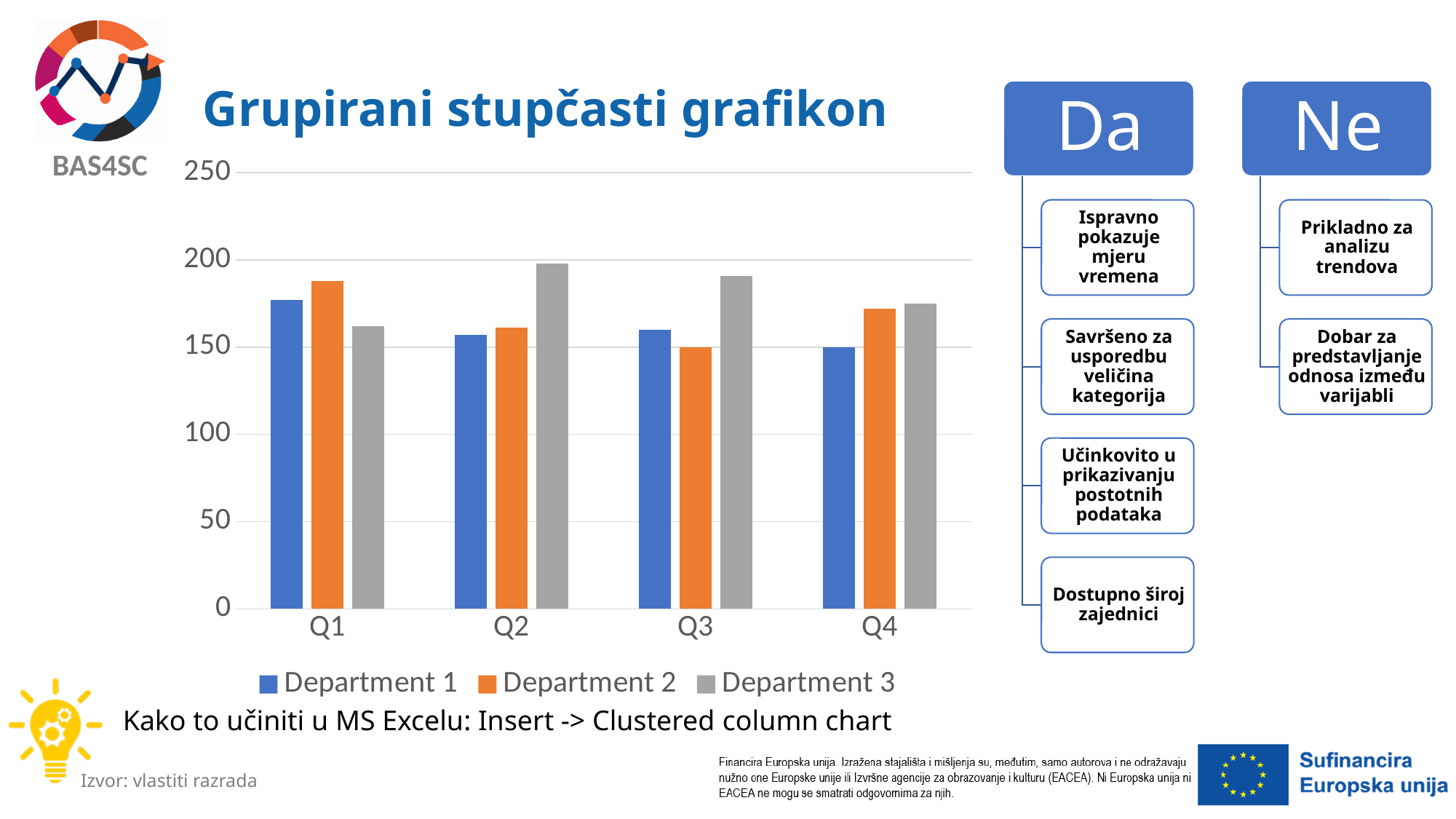
Which colour represents Department 2 in the chart? orange How many series does the chart legend list? 3 How many categories are shown on the x axis of the chart? 4 In Q2, which is larger: the value for Department 3 or the value for Department 1? Department 3 Is the value for Department 2 in Q1 greater or less than 200? less In Q1, which department has the lowest value? Department 3 In Q3, which department has the highest value? Department 3 In which quarter is the value for Department 2 the highest? Q1 What kind of chart is shown on the slide? bar chart Is the value for Department 1 in Q4 greater or less than 200? less Is the value for Department 1 in Q1 greater or less than 150? greater What is the title of the chart slide? Grupirani stupčasti grafikon